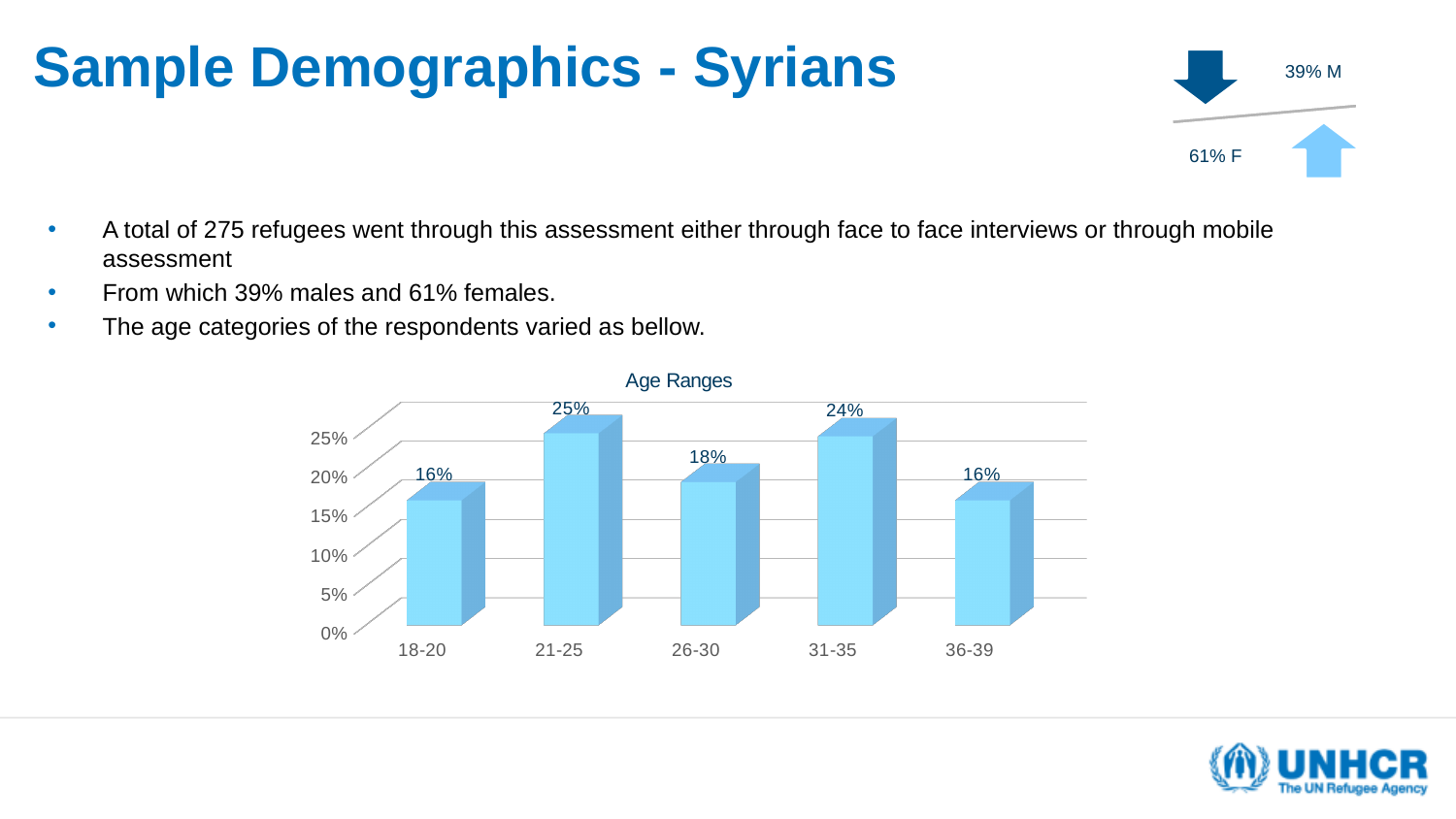
What kind of chart is shown on the slide? bar chart Which age range has the highest value? 21-25 What is the title of the chart? Age Ranges What is the value for the 21-25 age range? 25% What is the difference between the values for 31-35 and 36-39? 8% Which is larger, the value for 26-30 or the value for 18-20? 26-30 How many age ranges are shown on the chart? 5 Is the value for 31-35 greater or less than 20%? greater What is the difference between the values for 21-25 and 26-30? 7% What is the value for the 26-30 age range? 18% What is the value for the 31-35 age range? 24% Which age ranges share the lowest value of 16%? 18-20 and 36-39